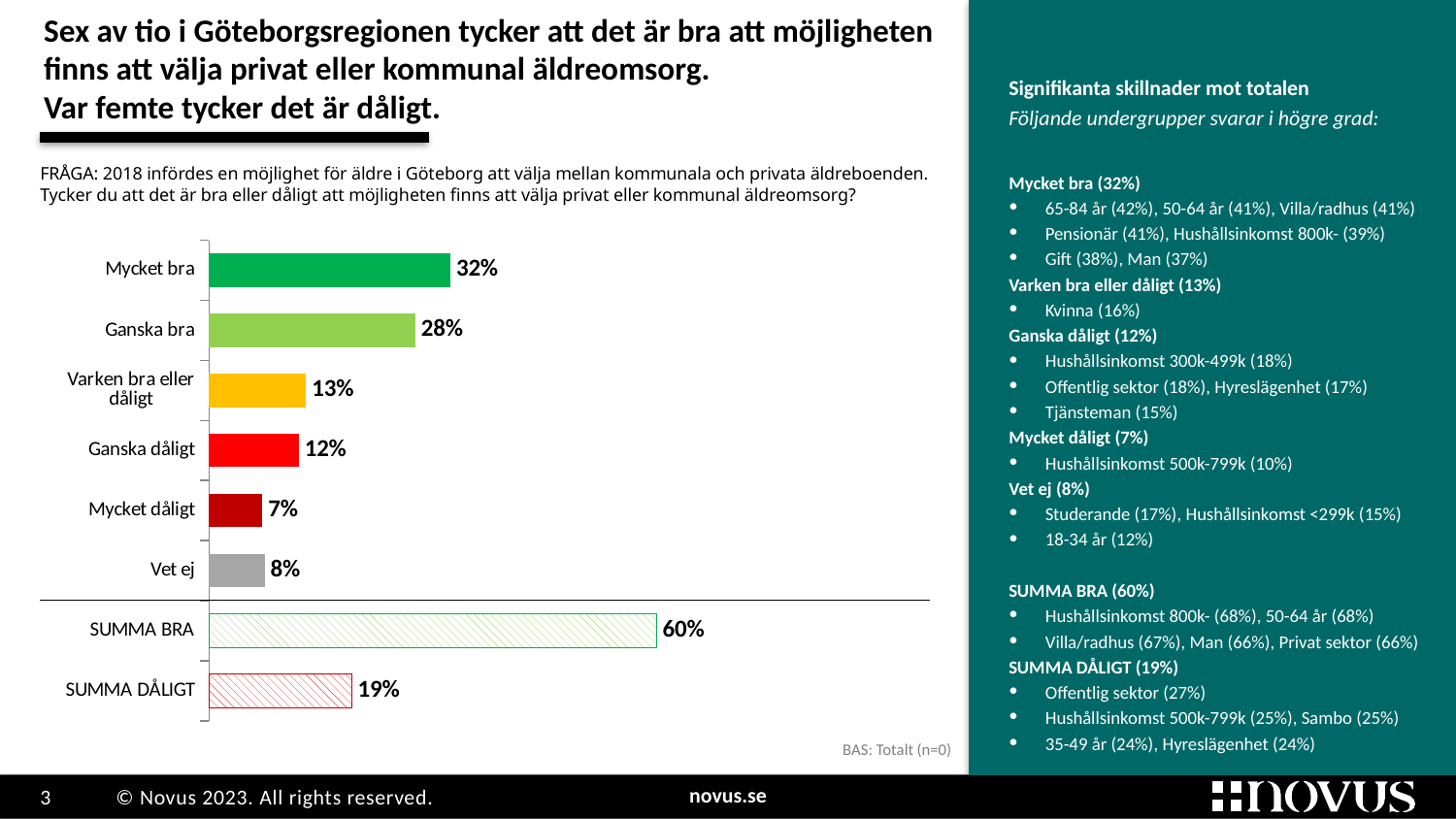
What is the difference between "Mycket bra" and "Ganska bra"? 4 percentage points What percentage is shown for "Vet ej"? 8% What is the difference between "SUMMA BRA" and "SUMMA DÅLIGT"? 41 percentage points Among the six individual response options (excluding the SUMMA bars), which has the highest value? Mycket bra How many bars are shown in the chart in total? 8 What is the value shown for "Ganska bra"? 28% What percentage of respondents answered "Mycket bra"? 32% Among the six individual response options (excluding the SUMMA bars), which has the lowest value? Mycket dåligt What type of chart is shown on the slide? Bar chart What is the value of the "SUMMA BRA" bar? 60% Which is larger, "Ganska dåligt" or "Mycket dåligt"? Ganska dåligt What value is shown for "Varken bra eller dåligt"? 13%